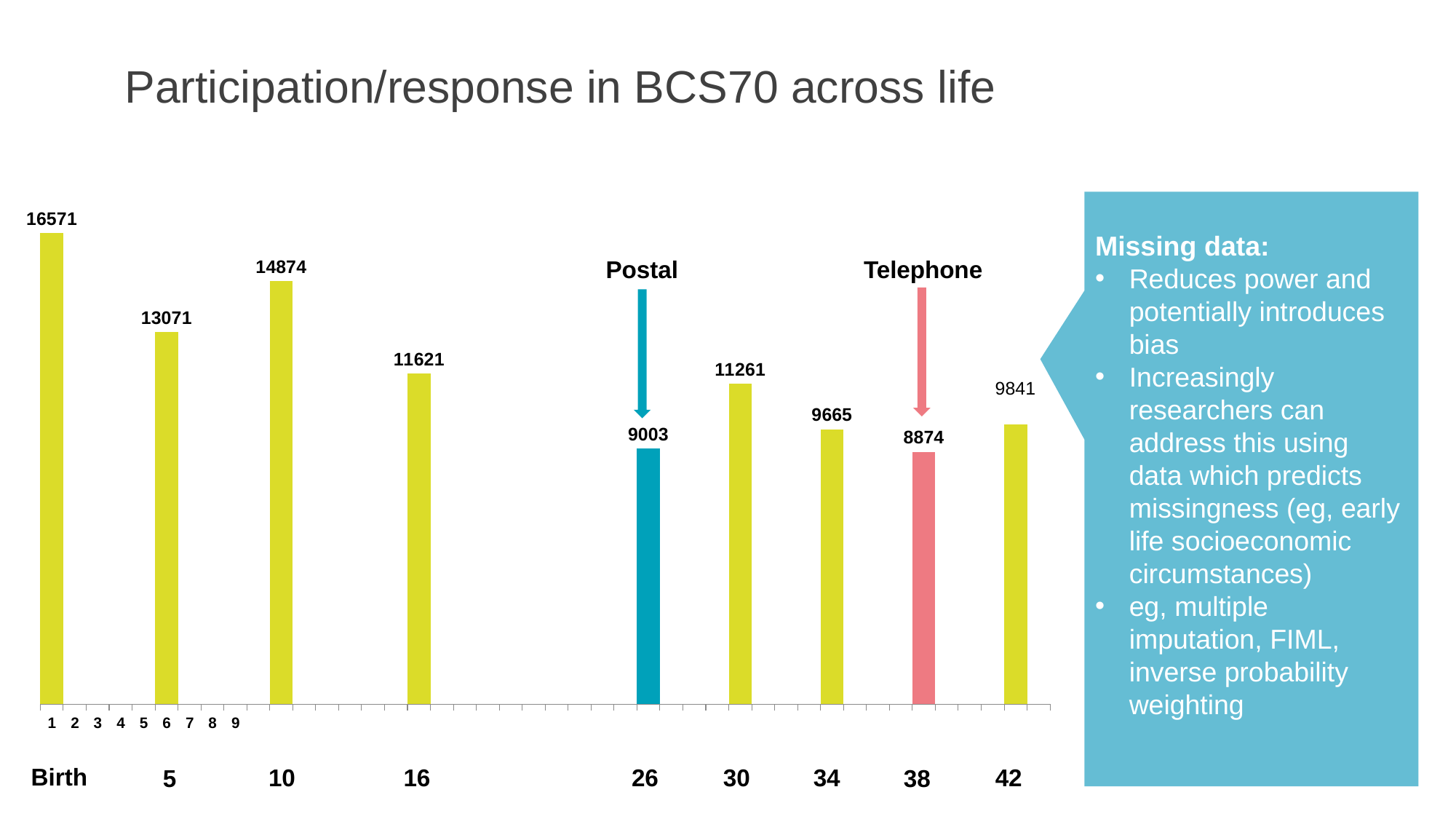
What is the participation value at Birth? 16571 Which survey mode is labelled for the bar at age 26? Postal Which is larger, participation at age 30 or at age 34? 30 How many age points (bars) are shown in the chart? 9 What kind of chart is shown on the slide? Bar chart What is the participation value at age 42? 9841 What is the participation value at age 26? 9003 What is the difference between participation at age 10 and at age 16? 3253 What is the participation value at age 38? 8874 What is the difference between participation at Birth and at age 42? 6730 Which age point has the lowest participation? 38 Which age point has the highest participation? Birth